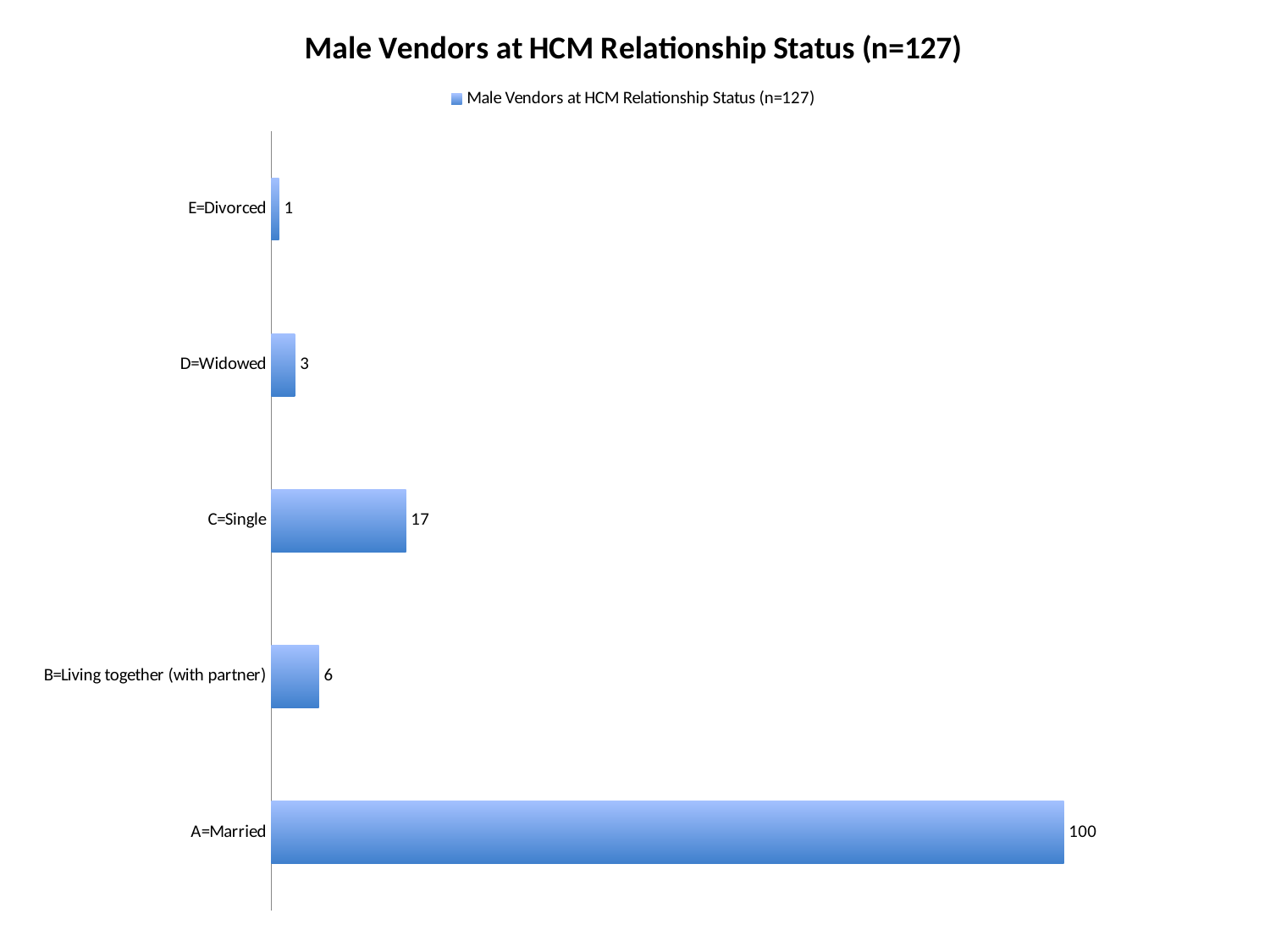
What is the value for C=Single? 17 Which category has the lowest value? E=Divorced Which is larger, the value for B=Living together (with partner) or the value for D=Widowed? B=Living together (with partner) What kind of chart is shown on the slide? Bar chart What is the difference between the values for A=Married and C=Single? 83 What is the value for E=Divorced? 1 How many categories are shown in the chart? 5 What is the title of the chart? Male Vendors at HCM Relationship Status (n=127) Which category has the highest value? A=Married What is the value for B=Living together (with partner)? 6 What is the value for D=Widowed? 3 What is the value for A=Married? 100